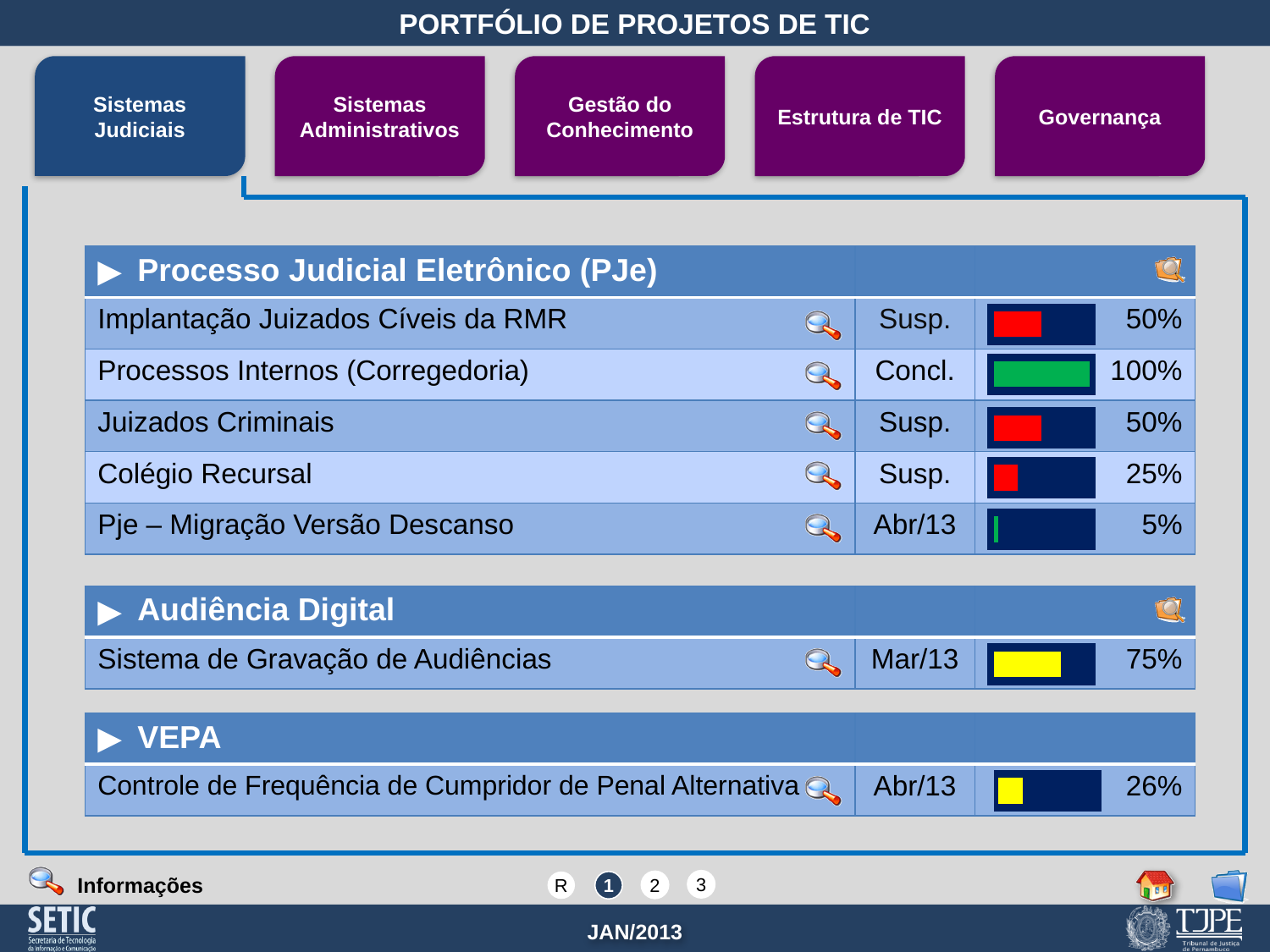
How many projects are listed under Processo Judicial Eletrônico (PJe)? 5 Which has a higher progress percentage, Juizados Criminais or Colégio Recursal? Juizados Criminais How many projects with progress bars are shown on the slide in total? 7 Which project has the highest progress percentage? Processos Internos (Corregedoria) What colour is the progress bar for Sistema de Gravação de Audiências? Yellow What is the progress percentage shown for Colégio Recursal? 25% What is the progress percentage shown for Pje – Migração Versão Descanso? 5% Which project has the lowest progress percentage? Pje – Migração Versão Descanso What is the difference in progress between Sistema de Gravação de Audiências and Controle de Frequência de Cumpridor de Penal Alternativa? 49 percentage points What colour is the progress bar for Processos Internos (Corregedoria)? Green What is the progress percentage shown for Sistema de Gravação de Audiências? 75% What status is shown for Processos Internos (Corregedoria)? Concl.